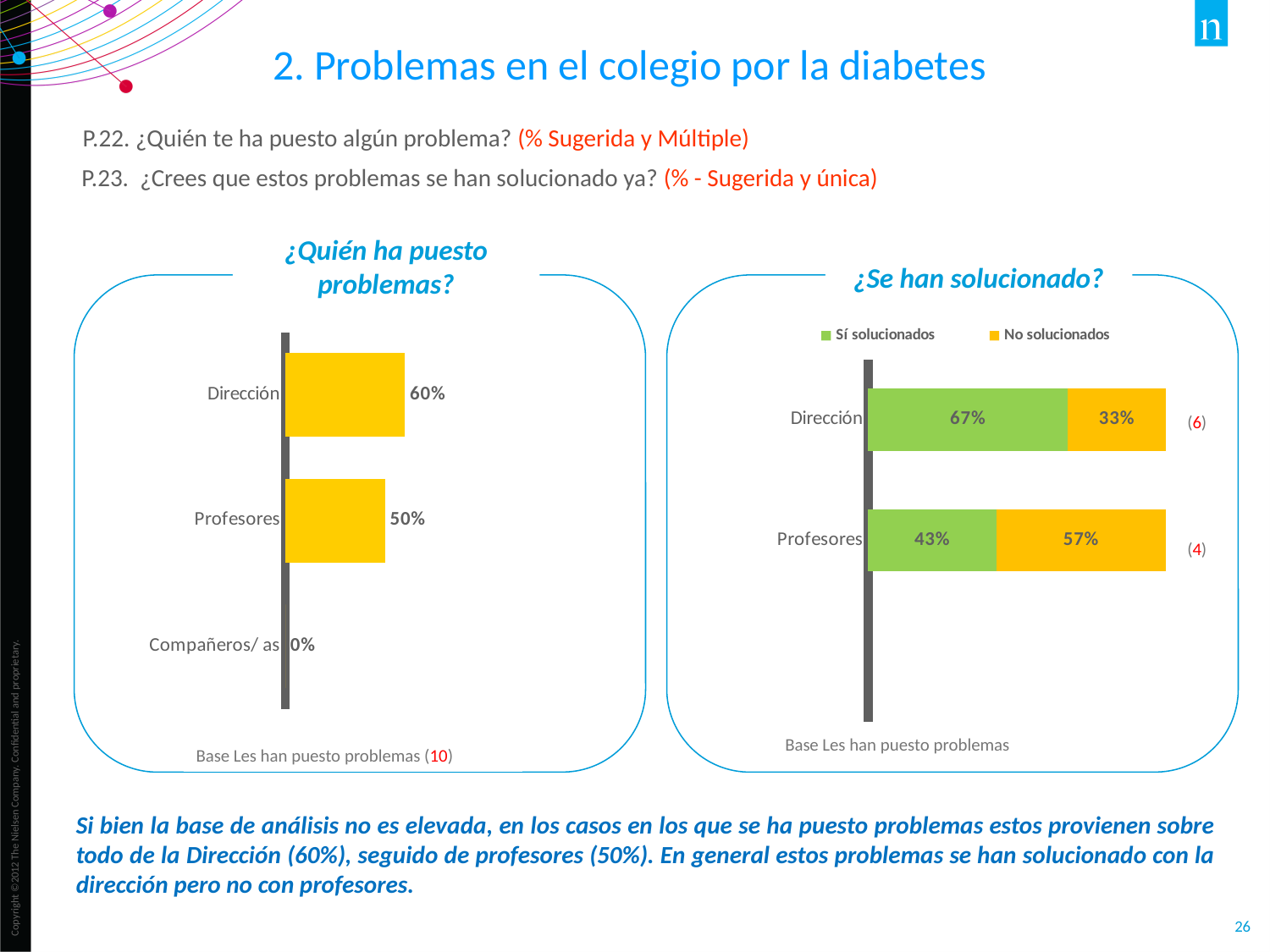
In the '¿Quién ha puesto problemas?' chart, which category has the highest value? Dirección In the '¿Se han solucionado?' chart, what is the 'Sí solucionados' value for Dirección? 67% In the '¿Se han solucionado?' chart, what is the 'No solucionados' value for Profesores? 57% In the '¿Se han solucionado?' chart, which is larger for Profesores: 'Sí solucionados' or 'No solucionados'? No solucionados In the '¿Quién ha puesto problemas?' chart, what is the difference between the values for Dirección and Profesores? 10% In the '¿Se han solucionado?' chart, how many series does the legend list? 2 In the '¿Quién ha puesto problemas?' chart, what is the value for Dirección? 60% In the '¿Quién ha puesto problemas?' chart, which category has the lowest value? Compañeros/ as What kind of chart is the '¿Quién ha puesto problemas?' chart? Bar chart In the '¿Quién ha puesto problemas?' chart, what is the value for Profesores? 50% In the '¿Se han solucionado?' chart, what is the total of the stacked bar for Dirección? 100% In the '¿Quién ha puesto problemas?' chart, how many categories are shown? 3